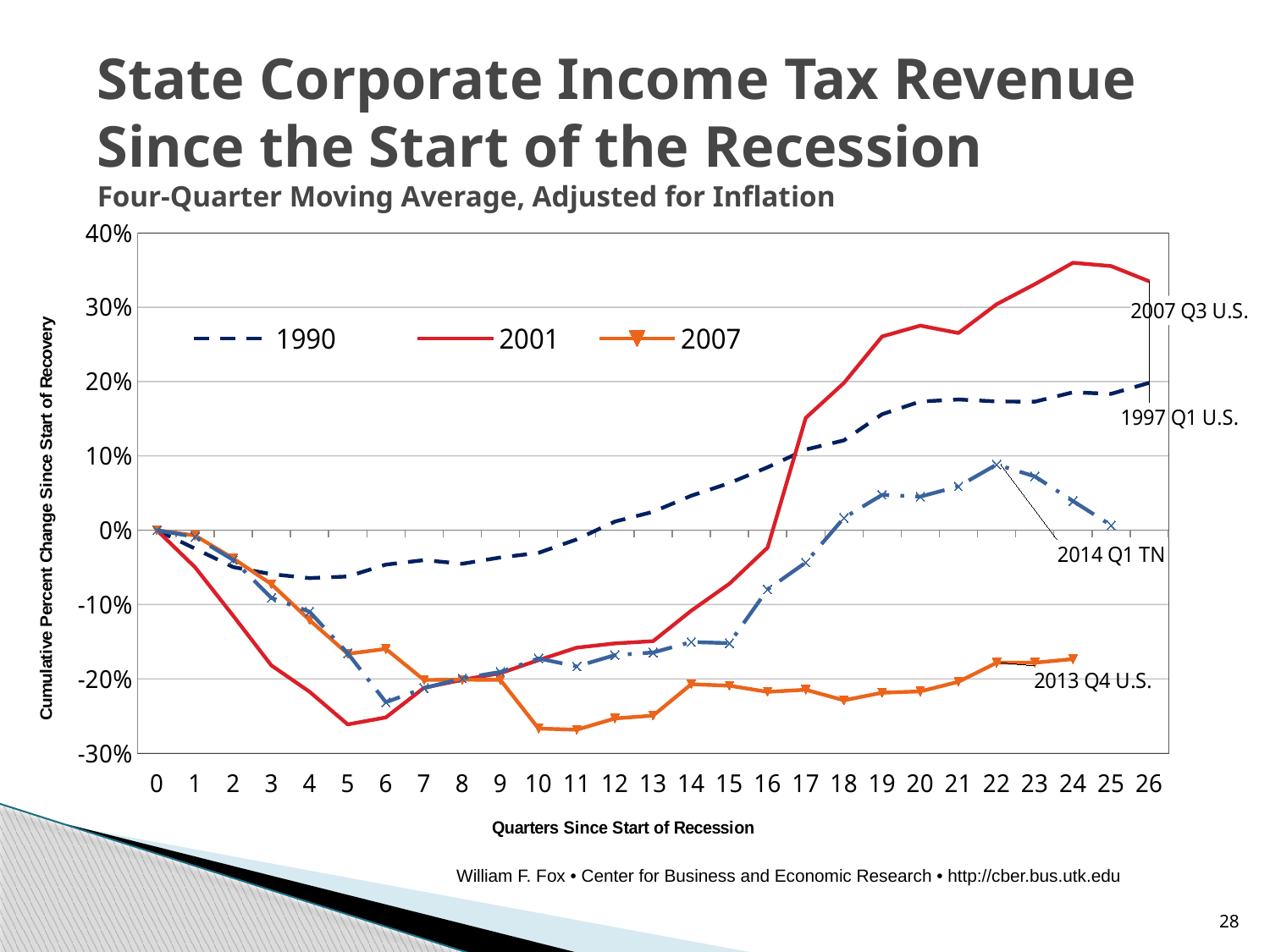
Is the value of the 2001 series at quarter 26 greater or less than 30%? greater What is the label of the y axis? Cumulative Percent Change Since Start of Recovery Does the 2001 series rise or fall between quarter 16 and quarter 24? rise What kind of chart is shown on the slide? line chart Is the value of the 2001 series at quarter 5 greater or less than -20%? less Which series reaches the highest value on the chart? 2001 Is the value of the 2007 series at quarter 11 greater or less than -20%? less What is the value of the 2001 series at quarter 0? 0% Which series has the lowest value at quarter 11? 2007 How many series does the legend list? 3 At quarter 20, which series has the larger value, 2001 or 1990? 2001